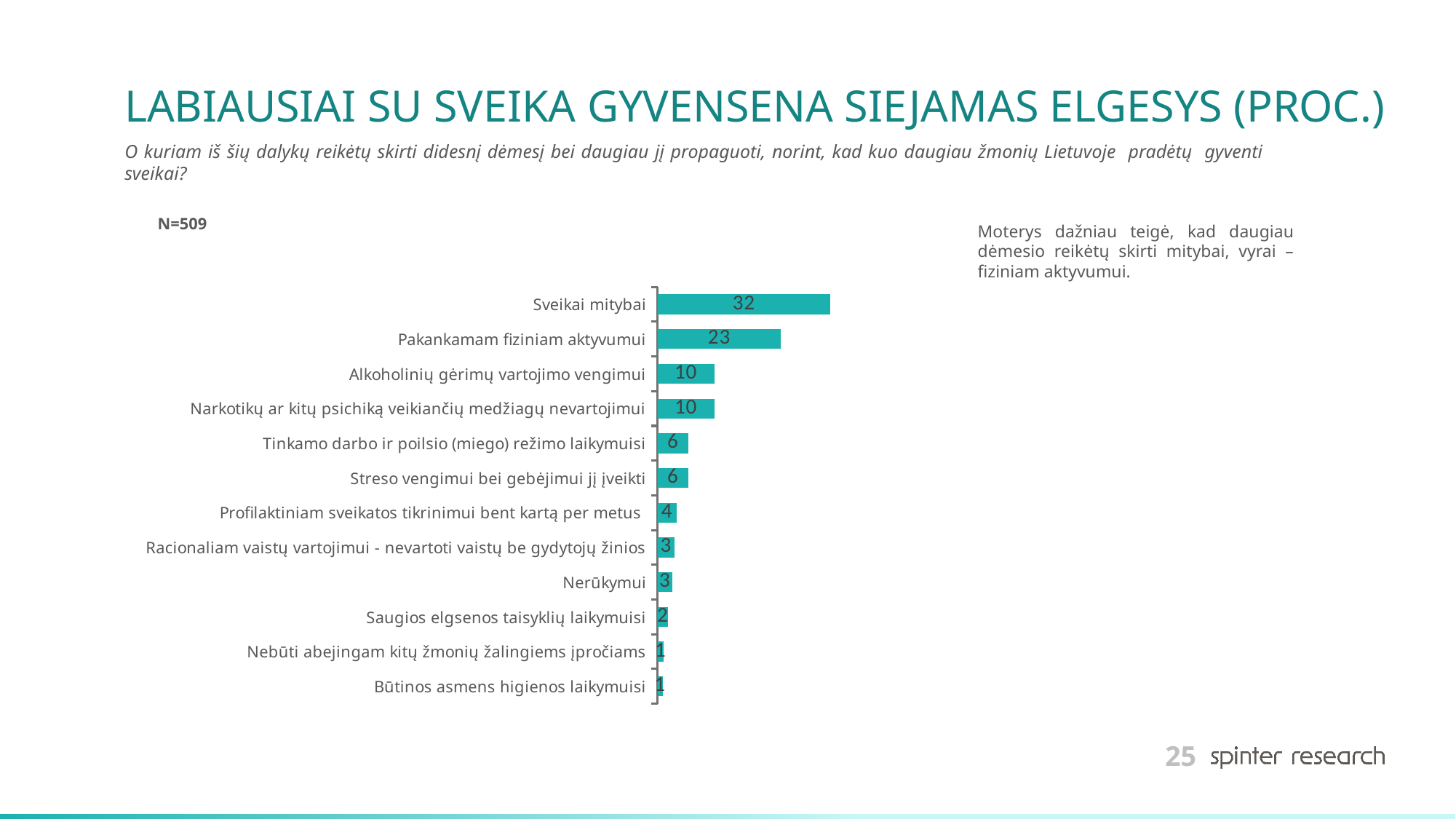
What sample size (N) is stated on the slide? N=509 What is the difference between the values for "Sveikai mitybai" and "Pakankamam fiziniam aktyvumui"? 9 What is the value for "Pakankamam fiziniam aktyvumui"? 23 What is the value for "Saugios elgsenos taisyklių laikymuisi"? 2 What is the value for "Sveikai mitybai"? 32 Which is larger: the value for "Alkoholinių gėrimų vartojimo vengimui" or the value for "Streso vengimui bei gebėjimui jį įveikti"? Alkoholinių gėrimų vartojimo vengimui How many categories are shown in the chart? 12 What kind of chart is shown on the slide? Bar chart What is the value for "Profilaktiniam sveikatos tikrinimui bent kartą per metus"? 4 What is the value for "Nerūkymui"? 3 What is the value for "Tinkamo darbo ir poilsio (miego) režimo laikymuisi"? 6 Which category has the highest value? Sveikai mitybai